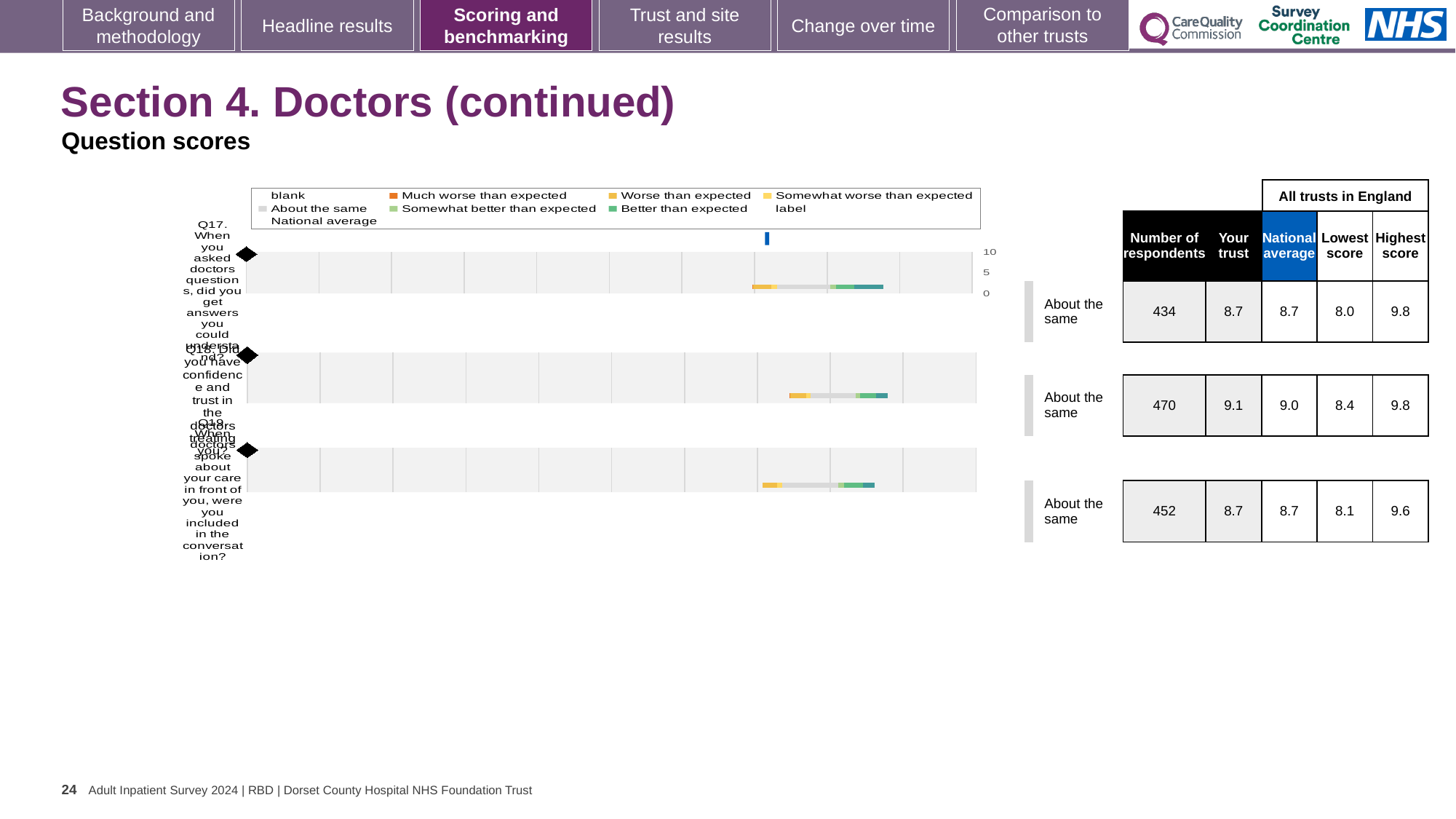
What is the highest value shown on the score axis of the charts? 10 What is the 'Your trust' score for Q17 (When you asked doctors questions, did you get answers you could understand)? 8.7 What kind of chart is used to show the question scores on this slide? bar chart How many questions (Q17, Q18, Q19) are plotted on the slide? 3 What is the 'Your trust' score for Q18 (Did you have confidence and trust in the doctors treating you)? 9.1 Which colour in the legend represents 'Much worse than expected'? orange Which question has the fewest respondents? Q17 What is the national average score for Q19 (When doctors spoke about your care in front of you, were you included in the conversation)? 8.7 What is the difference between the 'Your trust' score and the national average for Q18? 0.1 What is the difference between the highest score and the lowest score across all trusts in England for Q19? 1.5 Which question has the highest 'Your trust' score? Q18 How many respondents answered Q18? 470